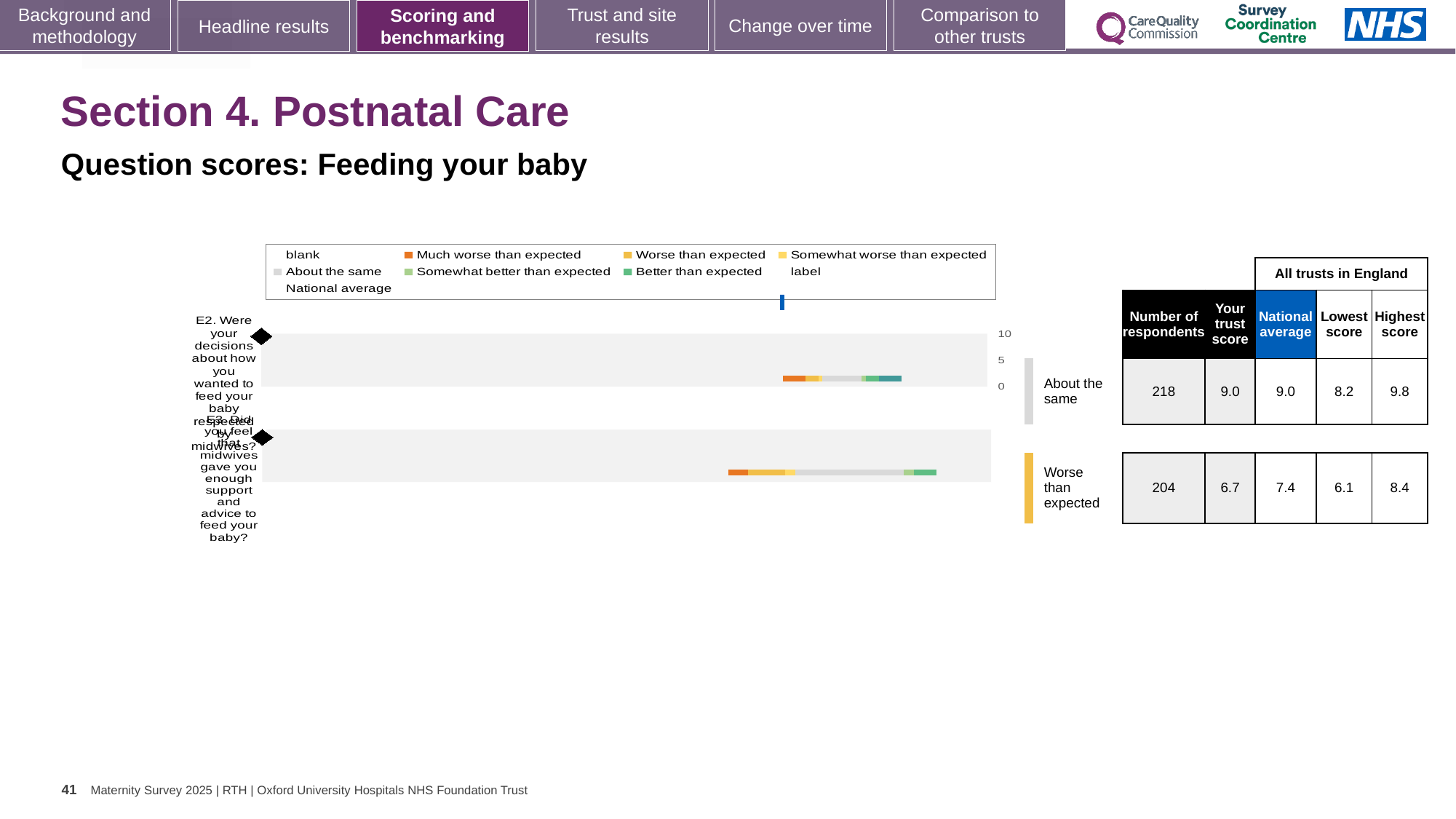
What is the lowest score among all trusts in England for question E3? 6.1 Which question has the higher trust score, E2 or E3? E2 What kind of chart is shown on the slide? bar chart What is the national average for question E3? 7.4 Which colour in the legend represents 'Much worse than expected'? orange What is the trust score for question E2 (decisions about how you wanted to feed your baby respected by midwives)? 9.0 Which benchmark category is question E3 placed in? Worse than expected How many respondents answered question E2? 218 What is the trust score for question E3 (midwives gave enough support and advice to feed your baby)? 6.7 What is the highest score among all trusts in England for question E2? 9.8 What is the difference between the trust scores for E2 and E3? 2.3 How many survey questions are plotted in the chart? 2